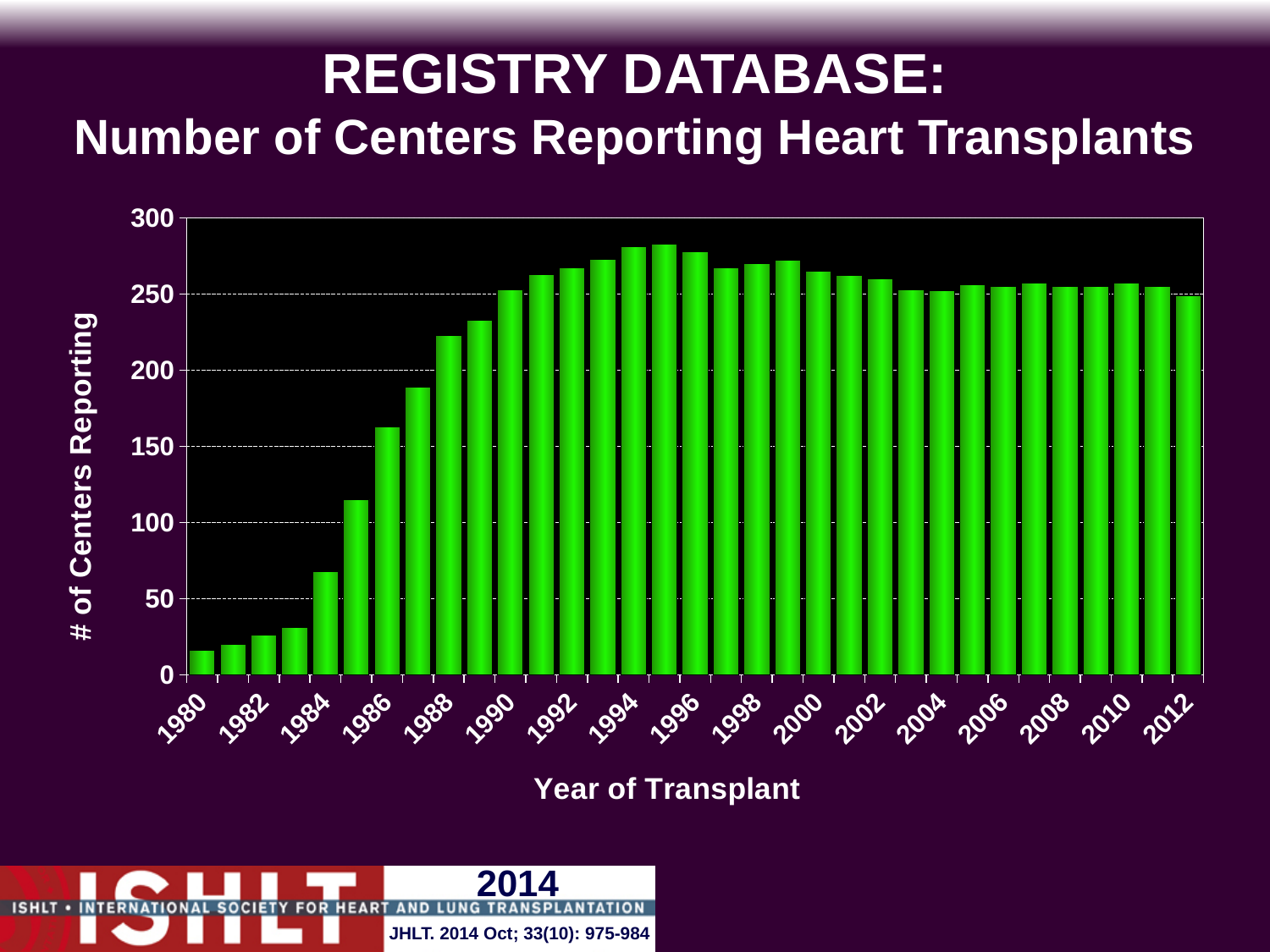
Which year has more centers reporting, 1984 or 1986? 1986 Which year has the lowest number of centers reporting? 1980 What is the label on the x axis of the chart? Year of Transplant What kind of chart is shown on the slide? bar chart How many years (bars) are plotted on the chart? 33 What is the label on the y axis of the chart? # of Centers Reporting Is the number of centers reporting in 1988 greater or less than 200? greater Is the number of centers reporting in 1987 greater or less than 200? less Does the number of centers reporting rise or fall from 1980 to 1995? rise Is the number of centers reporting in 1995 greater or less than 250? greater